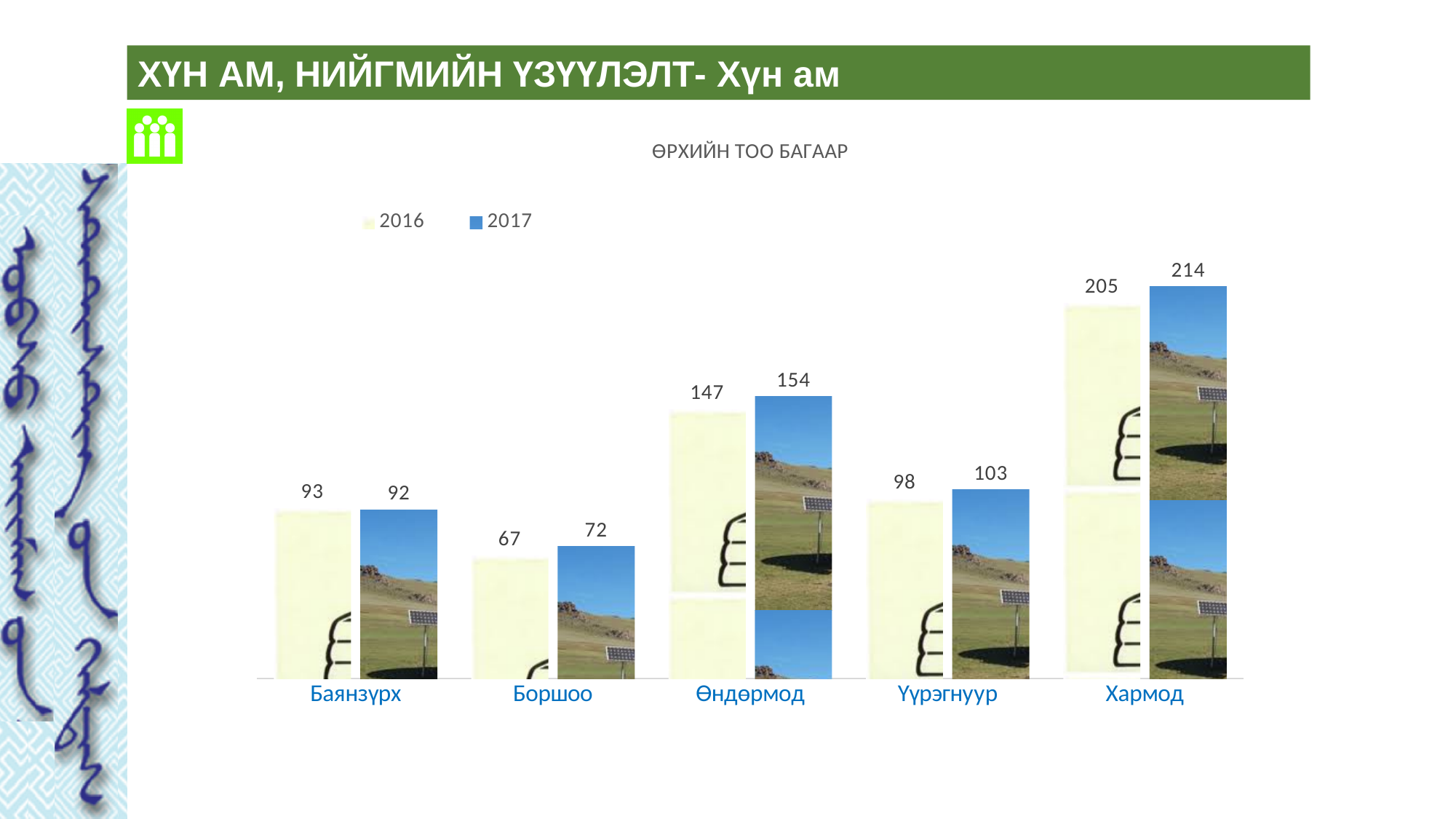
How many series does the legend list? 2 Which category has the highest 2016 value? Хармод What is the 2016 value for Боршоо? 67 How many categories are shown on the x axis? 5 What is the difference between the 2017 and 2016 values for Хармод? 9 What is the 2017 value for Хармод? 214 What is the difference between the 2017 and 2016 values for Өндөрмод? 7 What is the 2017 value for Өндөрмод? 154 Which category has the lowest 2017 value? Боршоо What is the title of the chart? ӨРХИЙН ТОО БАГААР What kind of chart is shown? bar chart Which is larger for Баянзүрх, the 2016 value or the 2017 value? 2016